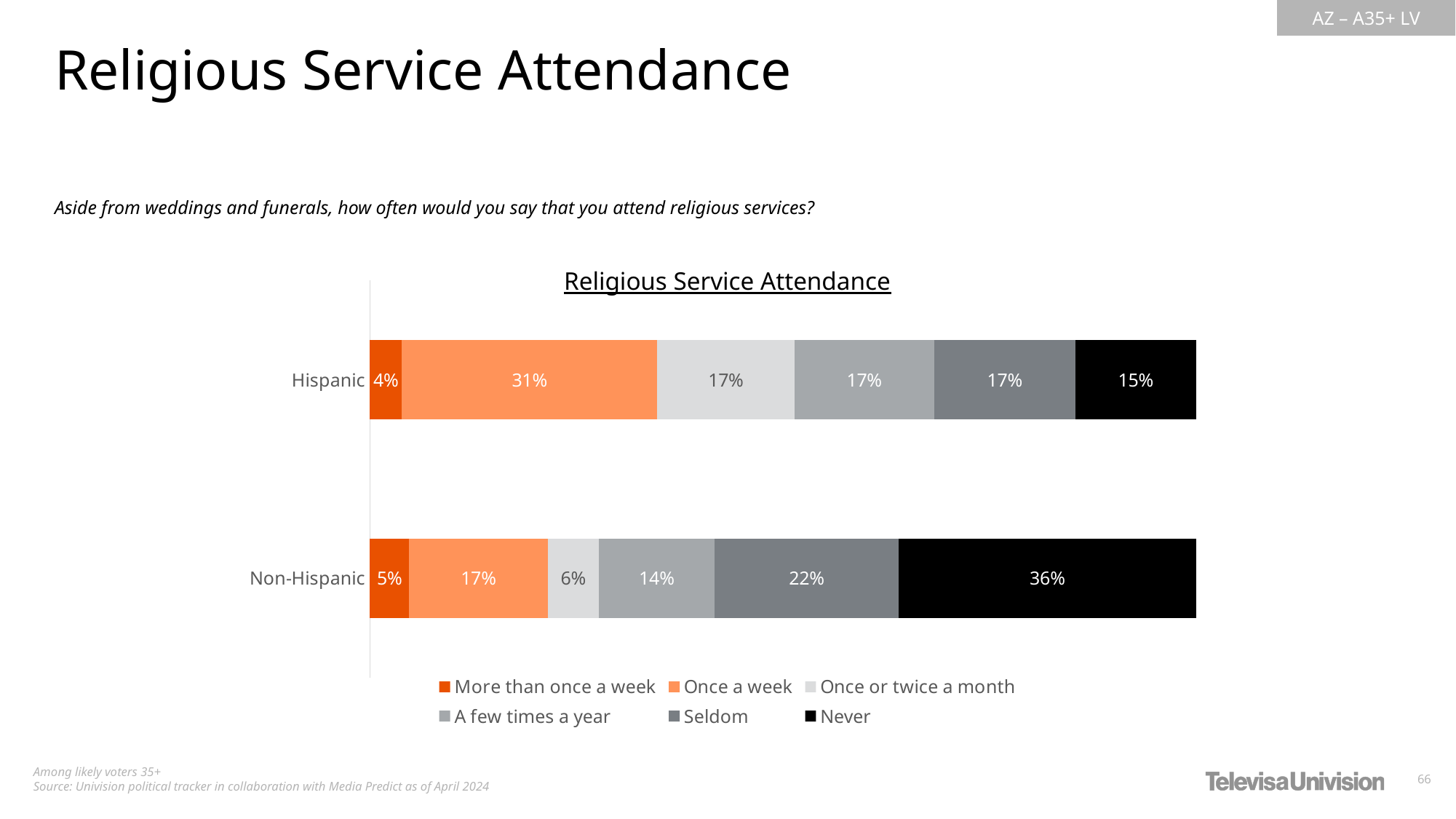
What is the difference between the Hispanic and Non-Hispanic shares for 'Once a week'? 14% What type of chart is shown on the slide? Stacked bar chart Which response category has the smallest share among Hispanic respondents? More than once a week Which response category has the largest share among Non-Hispanic respondents? Never What is the difference between the Non-Hispanic and Hispanic shares for 'Never'? 21% How many series does the legend list? 6 What percentage of Non-Hispanic respondents never attend religious services? 36% Which group has the larger share of respondents who never attend religious services, Hispanic or Non-Hispanic? Non-Hispanic What percentage of Hispanic respondents attend religious services more than once a week? 4% What percentage of Non-Hispanic respondents attend religious services once or twice a month? 6% What percentage of Hispanic respondents attend religious services once a week? 31% How many groups (bars) are shown in the chart? 2